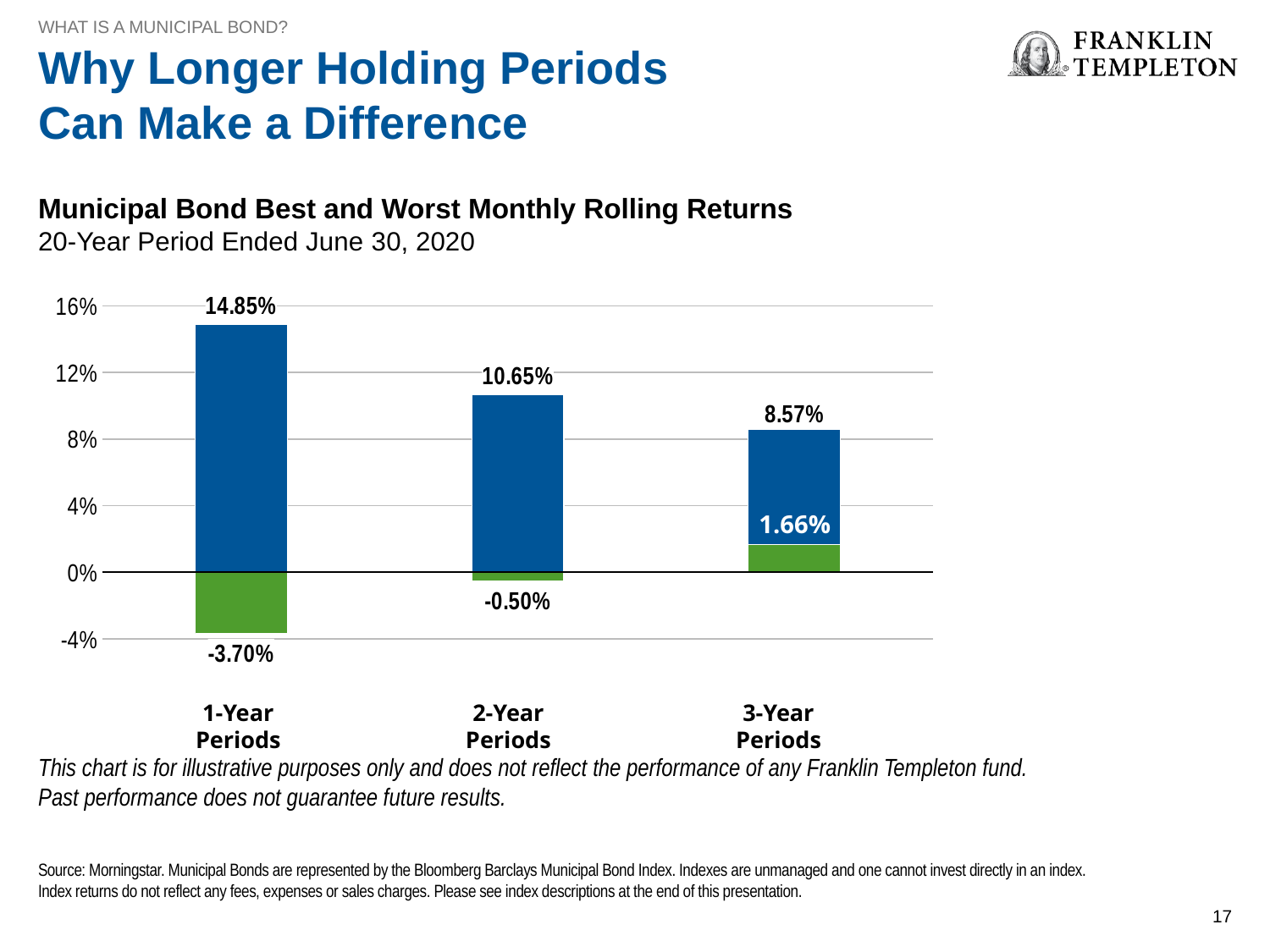
Which holding period has the lowest worst return on the chart? 1-Year Periods Which holding period has the highest best return on the chart? 1-Year Periods Which is larger, the worst return for 2-Year Periods or the worst return for 3-Year Periods? 3-Year Periods What is the difference between the best and worst returns for 3-Year Periods? 6.91% What is the worst monthly rolling return shown for 3-Year Periods? 1.66% What kind of chart is shown on the slide? Bar chart What is the best monthly rolling return shown for 1-Year Periods? 14.85% What is the worst monthly rolling return shown for 1-Year Periods? -3.70% What is the best monthly rolling return shown for 2-Year Periods? 10.65% Do the best returns rise or fall as the holding period lengthens from 1-Year to 3-Year Periods? Fall How many holding period categories are shown on the x axis? 3 What is the difference between the best return for 1-Year Periods and the best return for 2-Year Periods? 4.20%